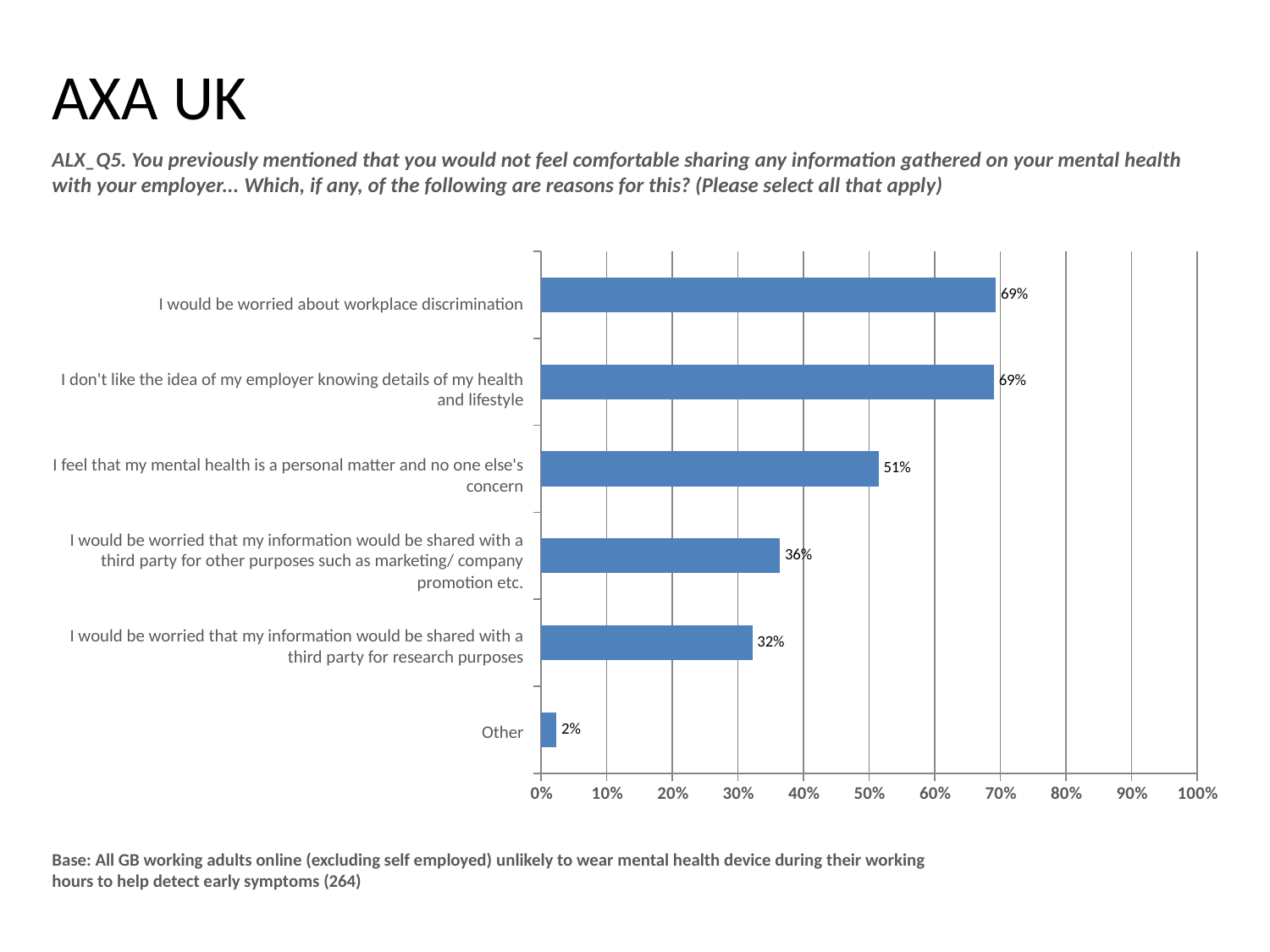
Which reason has the lowest percentage? Other What is the value for 'Other'? 2% What is the difference between the value for 'I feel that my mental health is a personal matter and no one else's concern' and the value for 'Other'? 49% What kind of chart is shown on the slide? Bar chart What percentage said they would be worried that their information would be shared with a third party for research purposes? 32% What percentage of respondents said they would be worried about workplace discrimination? 69% How many reasons (categories) are shown in the chart? 6 What is the base size stated below the chart? 264 What is the difference between the value for being worried about information shared with a third party for marketing/company promotion and the value for being worried about information shared with a third party for research purposes? 4% What is the value for 'I feel that my mental health is a personal matter and no one else's concern'? 51% Which is larger: the value for 'I would be worried about workplace discrimination' or the value for 'I feel that my mental health is a personal matter and no one else's concern'? I would be worried about workplace discrimination Is the value for 'I would be worried that my information would be shared with a third party for research purposes' greater or less than 40%? less